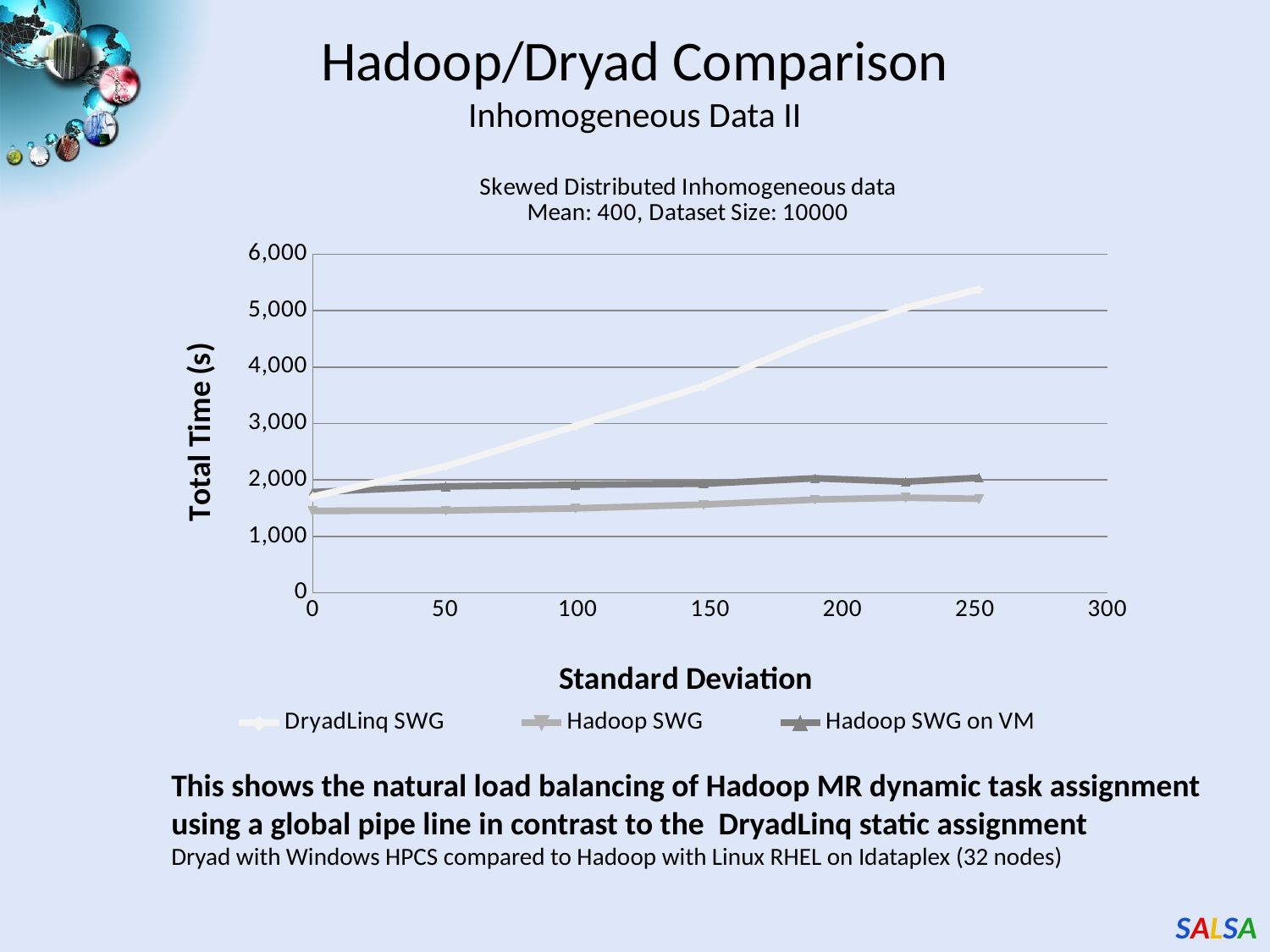
What is the label of the x axis? Standard Deviation What kind of chart is shown on the slide? line chart Which series has the lowest total time at a standard deviation of 250? Hadoop SWG Is the total time for Hadoop SWG at a standard deviation of 0 greater or less than 2,000? less Is the total time for DryadLinq SWG at a standard deviation of 150 greater or less than 3,000? greater What is the label of the y axis? Total Time (s) How many series does the legend list? 3 At a standard deviation of 250, which is larger: the total time for Hadoop SWG on VM or for Hadoop SWG? Hadoop SWG on VM Does the total time for DryadLinq SWG rise or fall as the standard deviation increases? rise At a standard deviation of 200, which is larger: the total time for DryadLinq SWG or for Hadoop SWG on VM? DryadLinq SWG Which series has the highest total time at a standard deviation of 250? DryadLinq SWG Is the total time for DryadLinq SWG at a standard deviation of 250 greater or less than 5,000? greater